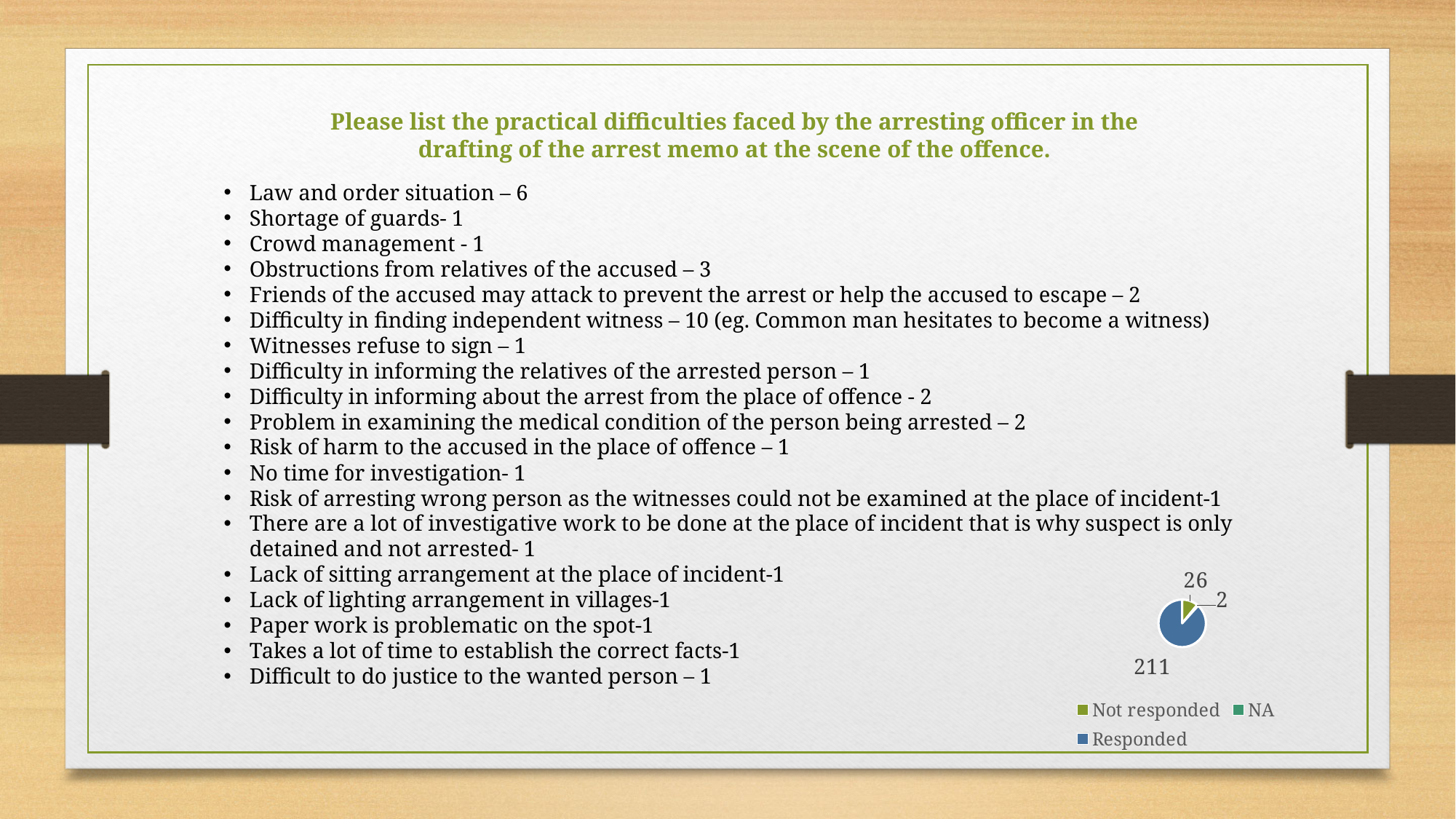
Which category has the smallest slice in the pie chart? NA What is the difference between the Responded and Not responded values in the pie chart? 185 In the pie chart, what is the value for Not responded? 26 What is the difference between the Not responded and NA values in the pie chart? 24 What colour represents Responded in the pie chart? blue Which category has the largest slice in the pie chart? Responded What type of chart is shown on the slide? pie chart How many categories does the pie chart legend list? 3 In the pie chart, what is the value for Responded? 211 In the pie chart, what is the value for NA? 2 What is the total of all the values shown in the pie chart? 239 Which is larger in the pie chart, Not responded or NA? Not responded